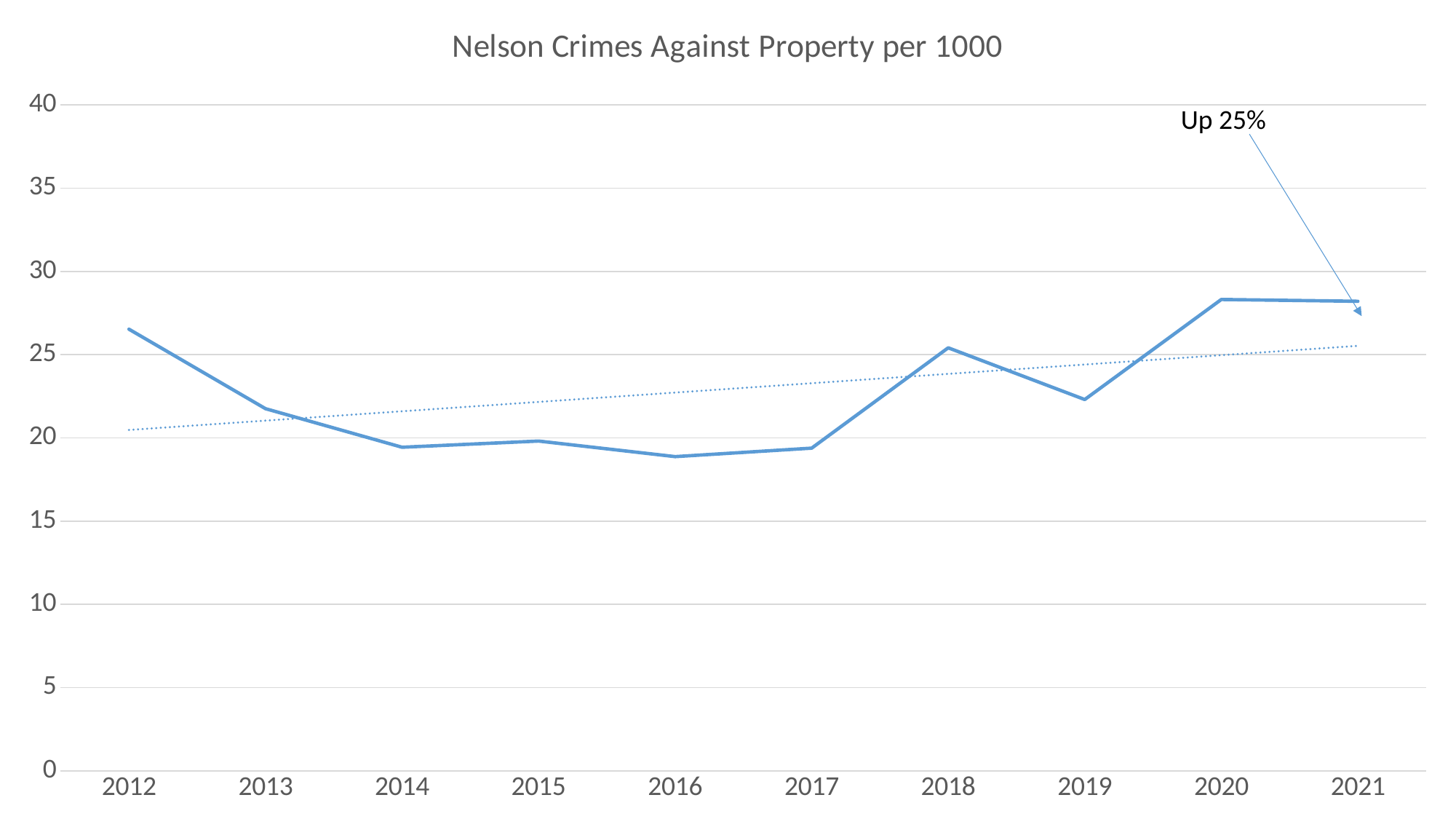
Which year has the larger value, 2012 or 2013? 2012 Is the value for 2019 greater or less than 25? less Do the values rise or fall from 2012 to 2014? fall What is the title of the chart? Nelson Crimes Against Property per 1000 Is the value for 2014 greater or less than 20? less Is the value for 2020 greater or less than 25? greater Which year has the larger value, 2018 or 2019? 2018 How many years are plotted along the x axis? 10 What does the annotation pointing at the 2021 data point say? Up 25% What type of chart is shown on the slide? line chart